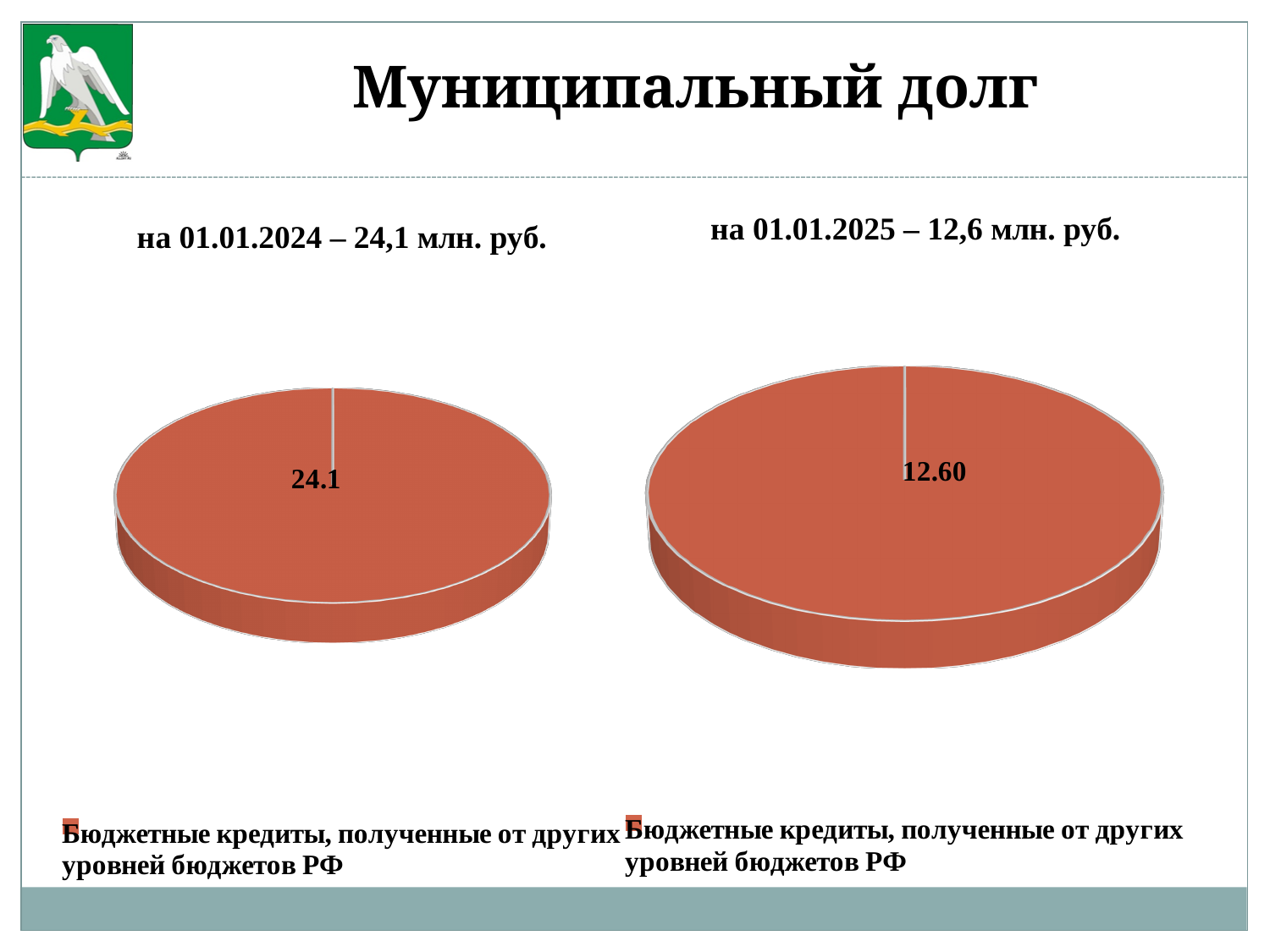
In the right pie chart (на 01.01.2025), what value is printed on the slice? 12.60 In the left pie chart (на 01.01.2024), what share of the pie does the slice 'Бюджетные кредиты, полученные от других уровней бюджетов РФ' take? 100% What is the difference between the value in the left chart (24.1) and the value in the right chart (12.60)? 11.5 Which chart shows the larger value: the left chart (на 01.01.2024) or the right chart (на 01.01.2025)? The left chart (на 01.01.2024) How many slices does the left pie chart (на 01.01.2024) contain? 1 How many slices does the right pie chart (на 01.01.2025) contain? 1 What is the legend entry shown under the right pie chart (на 01.01.2025)? Бюджетные кредиты, полученные от других уровней бюджетов РФ What is the title of the slide containing the two pie charts? Муниципальный долг In the left pie chart (на 01.01.2024), what value is printed on the slice? 24.1 What kind of chart is the left chart (на 01.01.2024)? Pie chart How many entries does the legend of the left pie chart (на 01.01.2024) list? 1 What kind of chart is the right chart (на 01.01.2025)? Pie chart